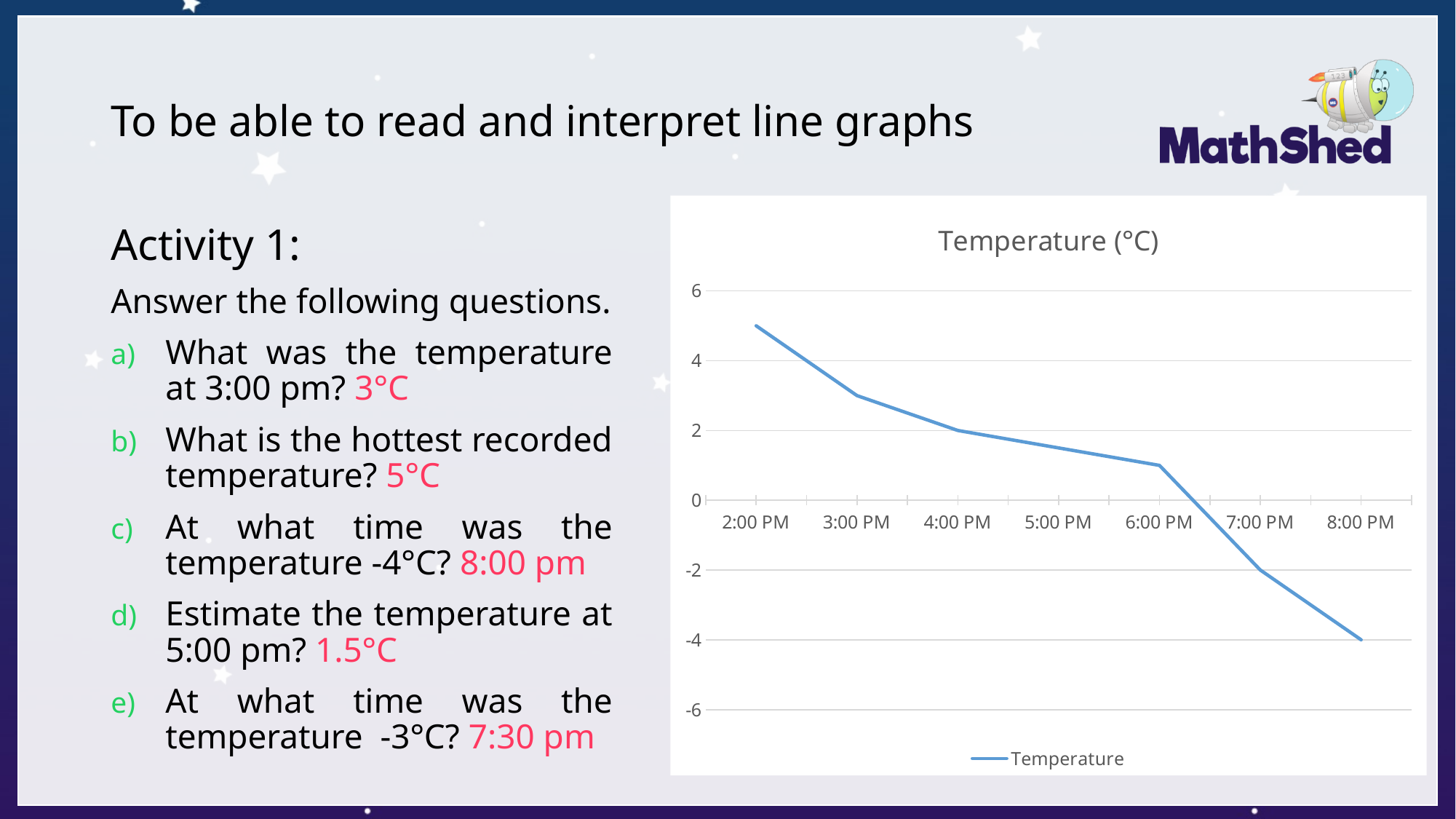
At which time is the temperature highest? 2:00 PM How many series does the legend list? 1 At which time is the temperature lowest? 8:00 PM What kind of chart is shown on the slide? line chart What is the difference between the temperature at 4:00 PM and at 8:00 PM? 6 What is the temperature at 4:00 PM? 2 Does the temperature rise or fall from 2:00 PM to 8:00 PM? fall What is the temperature at 8:00 PM? -4 What is the temperature at 7:00 PM? -2 How many time points are plotted on the x axis? 7 What is the title of the chart? Temperature (°C) Is the temperature at 6:00 PM greater or less than 2? less